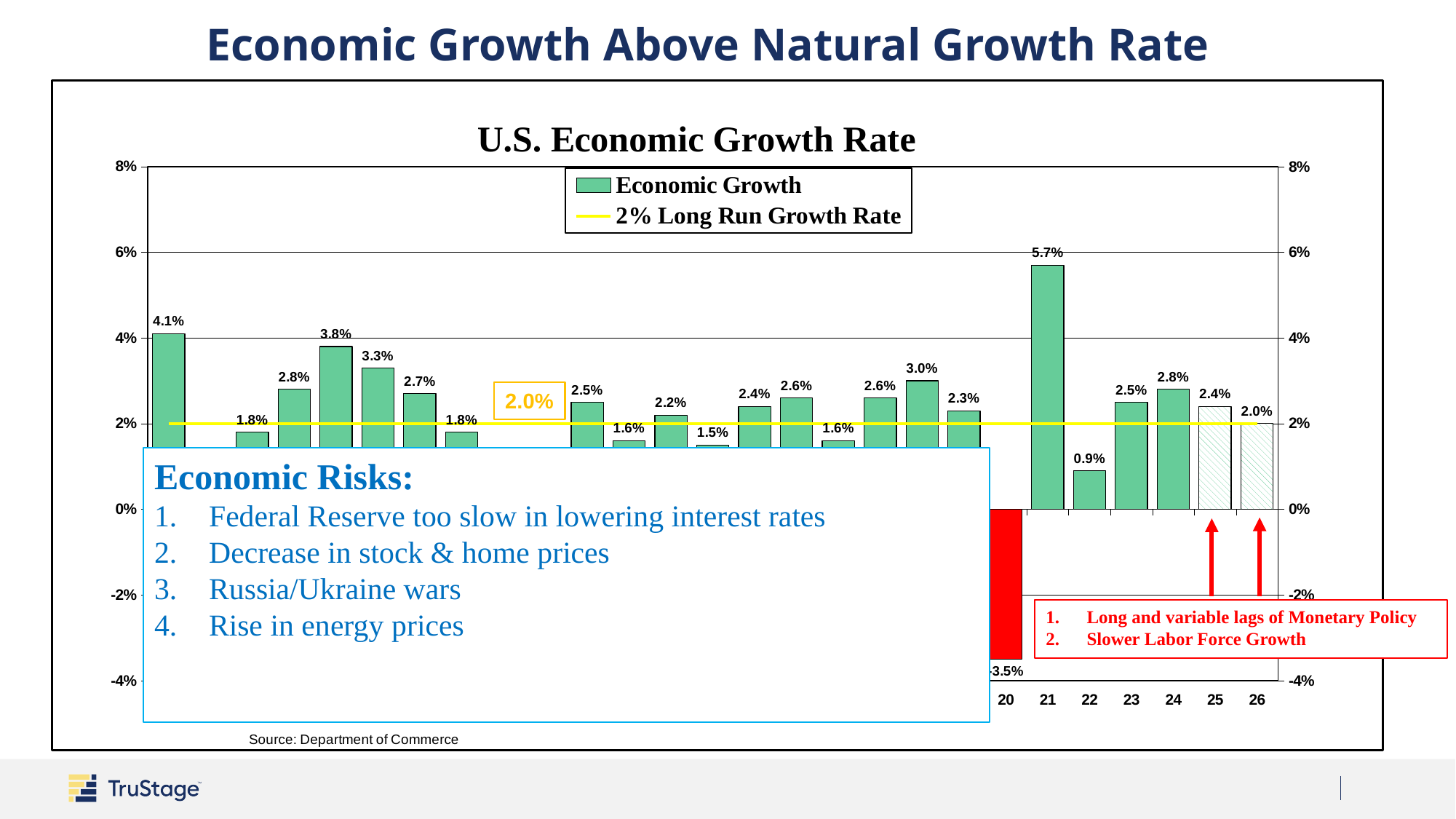
How many series does the legend list? 2 Which is larger, the value for 23 or the value for 24? 24 What is the value for 26 in the U.S. Economic Growth Rate chart? 2.0% What is the difference between the values for 21 and 22? 4.8% What is the value for 21 in the U.S. Economic Growth Rate chart? 5.7% What is the value for 22 in the U.S. Economic Growth Rate chart? 0.9% Which year has the highest economic growth rate in the chart? 21 What is the value for 24 in the U.S. Economic Growth Rate chart? 2.8% What is the value for 20 in the U.S. Economic Growth Rate chart? -3.5% What kind of chart is shown on the slide? combination bar and line chart Is the value for 21 greater or less than 4%? greater Which year has the lowest economic growth rate in the chart? 20